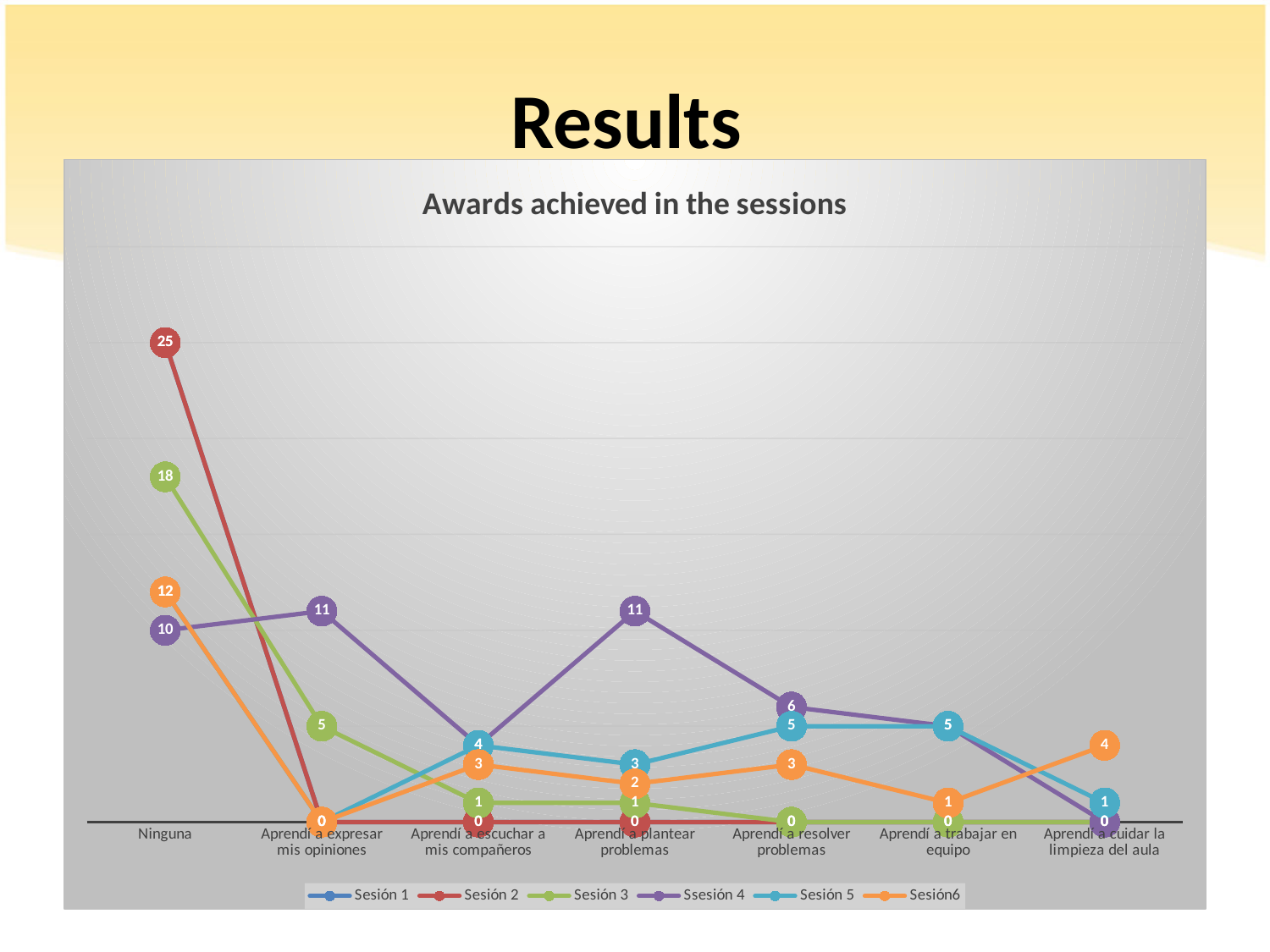
How many series does the legend list? 6 What is the value for Ssesión 4 at Aprendí a plantear problemas? 11 How many categories are shown on the x axis? 7 What is the title of the chart? Awards achieved in the sessions What is the value for Sesión 3 at Ninguna? 18 What is the value for Sesión6 at Aprendí a cuidar la limpieza del aula? 4 What is the difference between Sesión 2 and Sesión 3 at Ninguna? 7 What kind of chart is this? line chart Which is larger at Ninguna, Sesión 3 or Ssesión 4? Sesión 3 What is the value for Sesión 2 at Ninguna? 25 What is the value for Sesión6 at Ninguna? 12